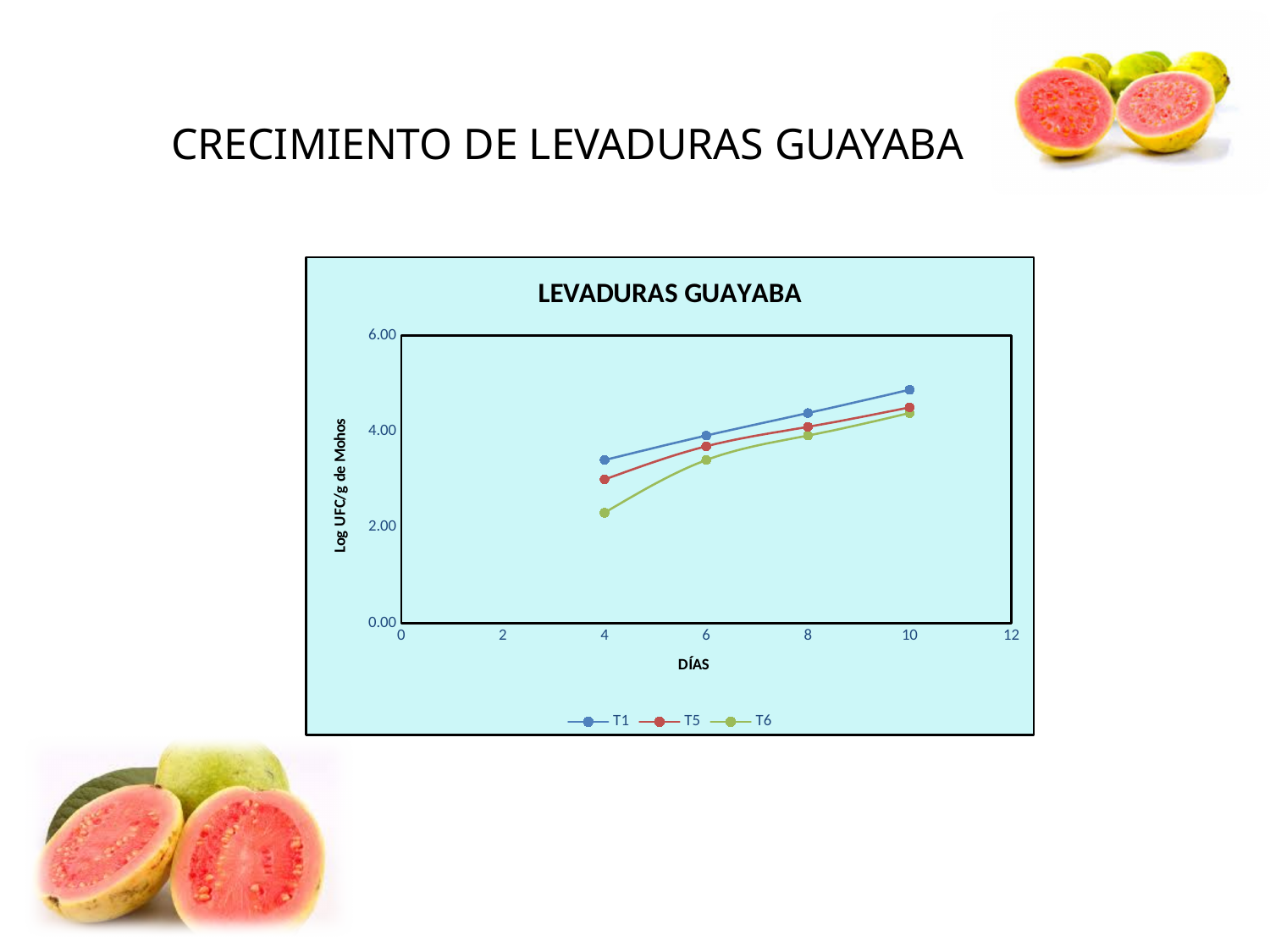
What is the title of the chart? LEVADURAS GUAYABA How many data points are plotted for the T1 series? 4 Which series has the lowest value at day 4? T6 Do the values of the T6 series rise or fall as the days increase? Rise Which series has the highest value at day 4? T1 Is the value for T1 at day 10 greater or less than 4.00? greater Is the value for T6 at day 4 greater or less than 2.00? greater At day 10, which is larger, the value for T1 or the value for T6? T1 Is the value for T6 at day 4 greater or less than 4.00? less What are the names of the series in the chart's legend? T1, T5, T6 What kind of chart is shown on the slide? Line chart How many series does the legend of the chart list? 3